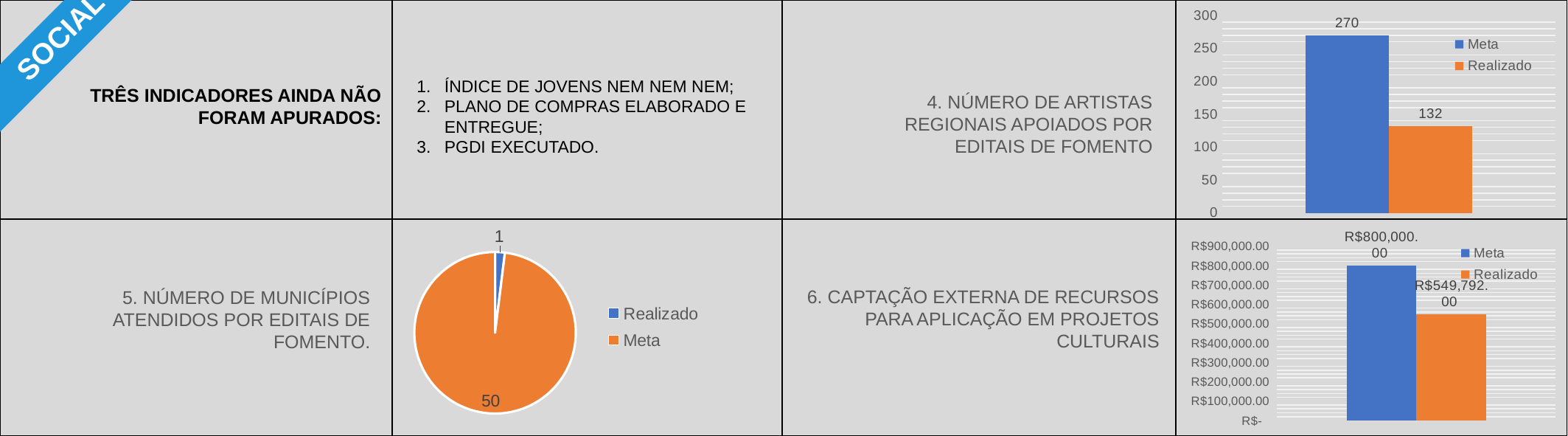
In the bottom-right bar chart (captação externa de recursos), what colour is the Realizado bar? Orange In the top-right bar chart (número de artistas regionais apoiados), which series is larger, Meta or Realizado? Meta In the bottom-middle pie chart (número de municípios atendidos), what is the value for Meta? 50 How many series does the legend of the top-right bar chart list? 2 In the bottom-right bar chart (captação externa de recursos), what is the value for Meta? R$800,000.00 In the top-right bar chart (número de artistas regionais apoiados por editais de fomento), what is the value for Realizado? 132 In the bottom-middle pie chart (número de municípios atendidos), what is the value for Realizado? 1 In the bottom-right bar chart (captação externa de recursos), what is the value for Realizado? R$549,792.00 In the top-right bar chart (número de artistas regionais apoiados por editais de fomento), what is the value for Meta? 270 In the top-right bar chart (número de artistas regionais apoiados), what is the difference between Meta and Realizado? 138 In the bottom-middle pie chart (número de municípios atendidos), which slice is the smallest? Realizado What kind of chart is shown in the bottom-middle cell (número de municípios atendidos por editais de fomento)? Pie chart